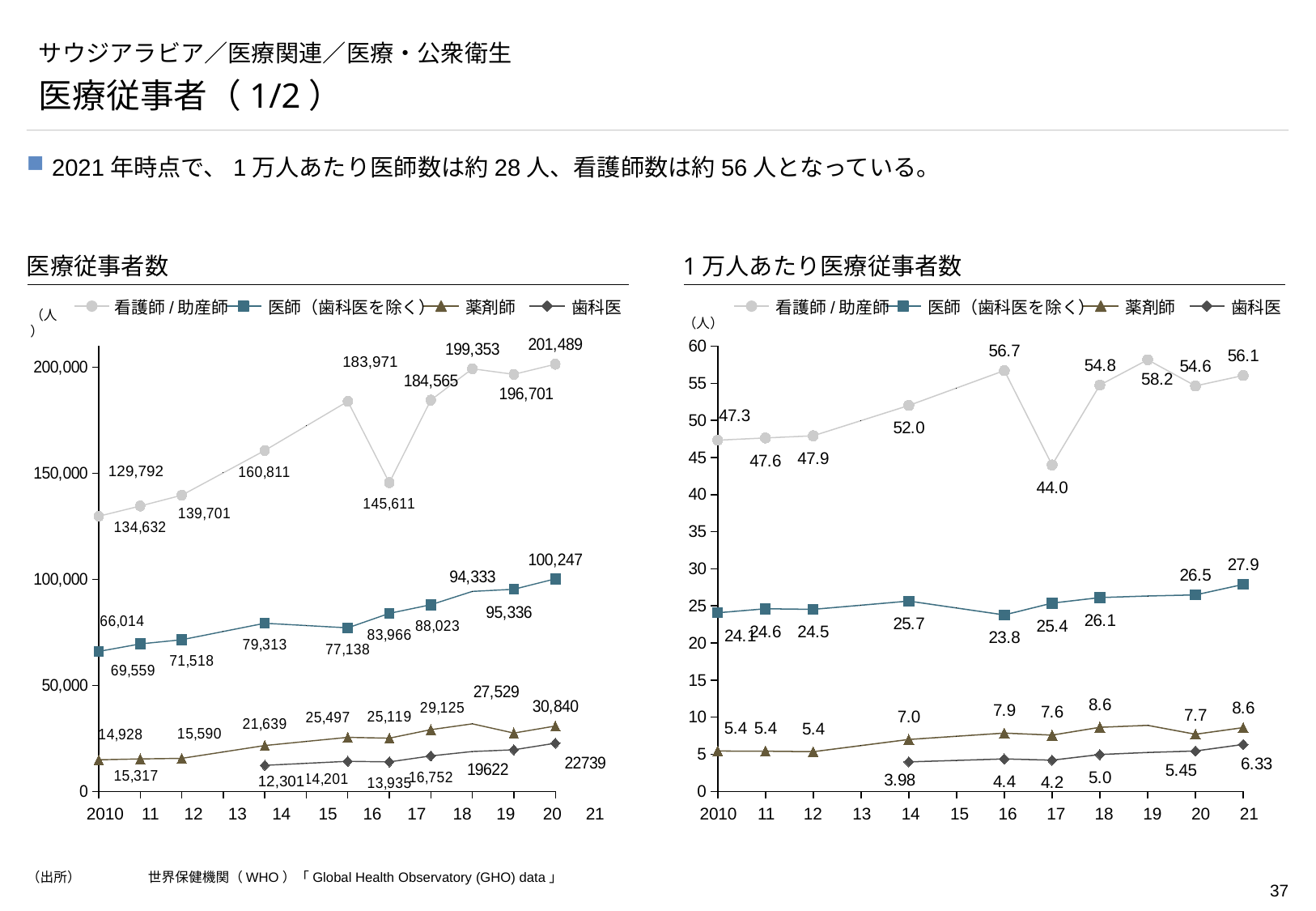
In the right chart (1万人あたり医療従事者数), what is the difference between the 看護師/助産師 value and the 医師（歯科医を除く） value in 2021? 28.2 In the right chart (1万人あたり医療従事者数), in which year is the 看護師/助産師 value lowest? 2017 In the right chart (1万人あたり医療従事者数), what is the value for 看護師/助産師 in 2021? 56.1 In the left chart (医療従事者数), what is the value for 看護師/助産師 in 2010? 129,792 In the left chart (医療従事者数), what is the value for 医師（歯科医を除く） in 2010? 66,014 In the right chart (1万人あたり医療従事者数), is the 看護師/助産師 value larger in 2016 or in 2017? 2016 In the right chart (1万人あたり医療従事者数), in which year is the 看護師/助産師 value highest? 2019 How many series does the legend of the right chart (1万人あたり医療従事者数) list? 4 In the left chart (医療従事者数), what is the highest value shown for 看護師/助産師? 201,489 In the right chart (1万人あたり医療従事者数), what is the value for 歯科医 in 2014? 3.98 What kind of chart is the left chart titled 医療従事者数? line chart In the right chart (1万人あたり医療従事者数), what is the value for 医師（歯科医を除く） in 2021? 27.9